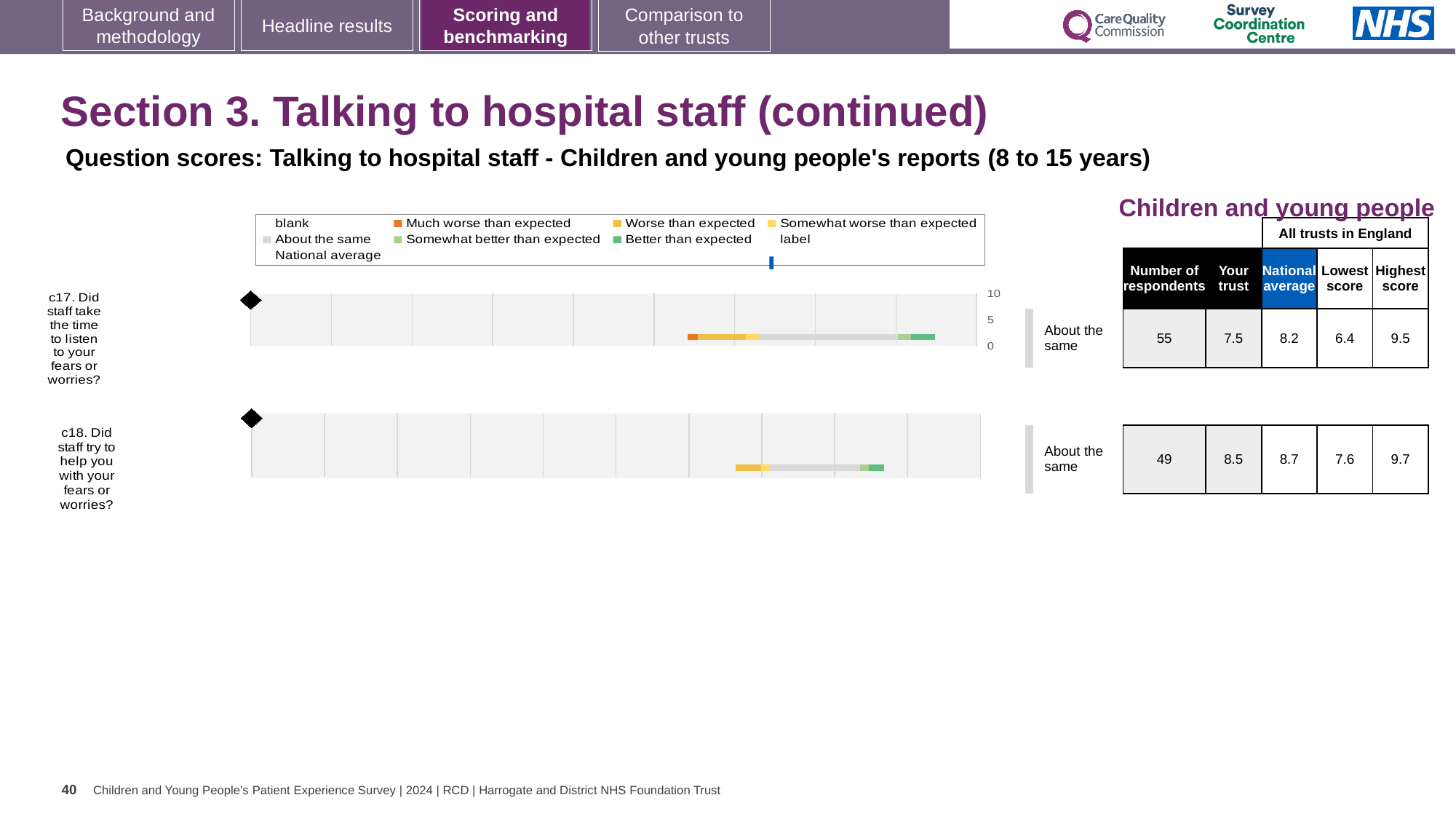
What kind of chart is used to show the question scores on this slide? Bar chart How many questions are charted on this slide? 2 What benchmark category is shown for question c17? About the same For question c18, what is the difference between the highest and lowest scores across all trusts in England? 2.1 Which question has the higher 'Your trust' score, c17 or c18? c18 What is the 'Your trust' score for question c17 (Did staff take the time to listen to your fears or worries?)? 7.5 For question c17, how much higher is the national average than the trust's score? 0.7 What is the highest score among all trusts in England for question c18? 9.7 How many respondents answered question c17? 55 What is the national average score for question c18 (Did staff try to help you with your fears or worries?)? 8.7 Which question had more respondents, c17 or c18? c17 What is the lowest score among all trusts in England for question c17? 6.4